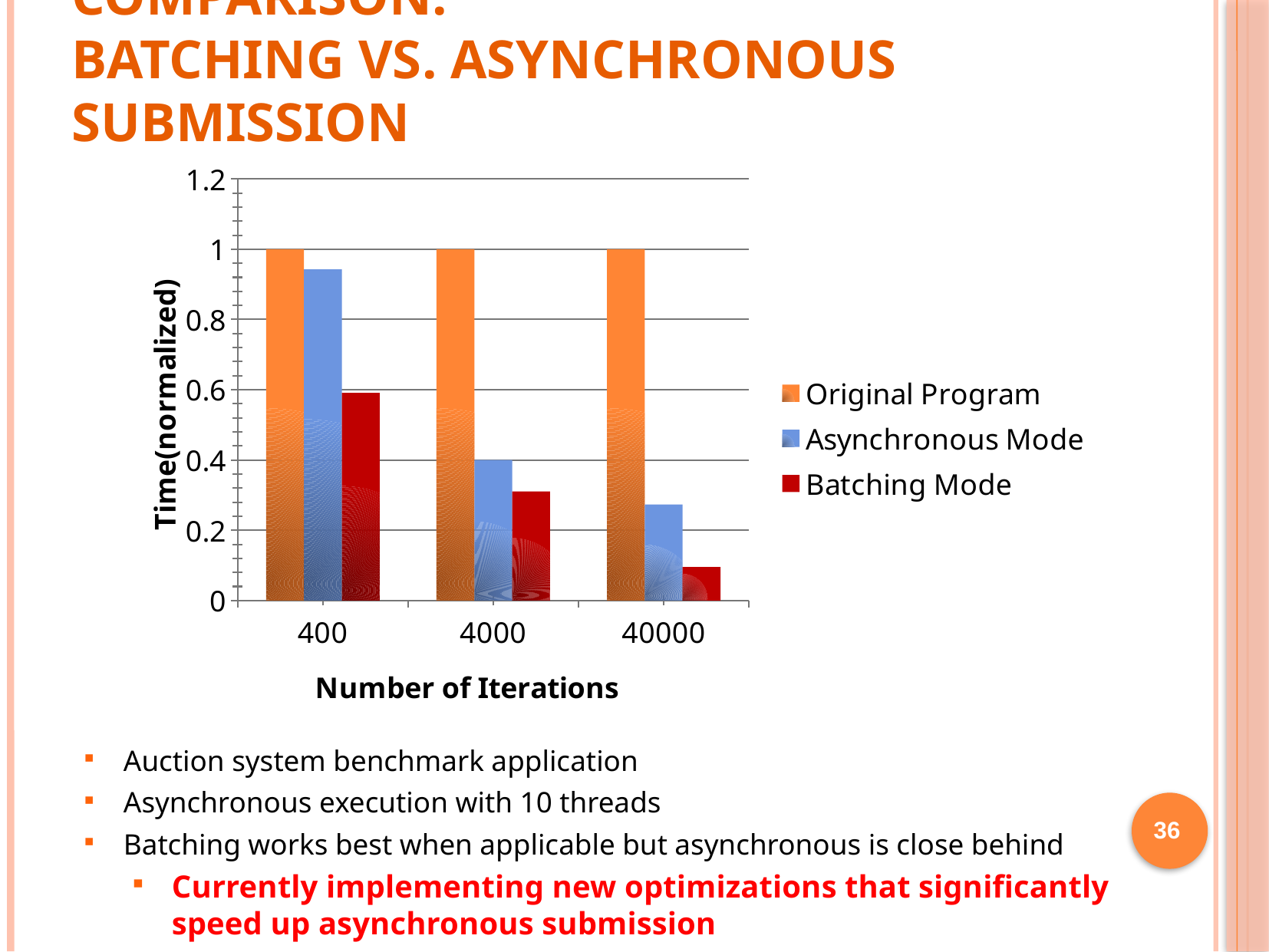
Is the value for Batching Mode at 400 iterations greater or less than 0.4? greater How many series does the legend list? 3 What is the value for Original Program at 400 iterations? 1 What is the label of the y axis? Time(normalized) Is the value for Asynchronous Mode at 400 iterations greater or less than 0.8? greater Do the Batching Mode values rise or fall as the number of iterations increases? fall Which series has the lowest value at 4000 iterations? Batching Mode Is the value for Batching Mode at 40000 iterations greater or less than 0.2? less Which is larger at 40000 iterations, Asynchronous Mode or Batching Mode? Asynchronous Mode What is the value for Original Program at 40000 iterations? 1 What kind of chart is shown on the slide? bar chart How many categories are shown on the x axis? 3